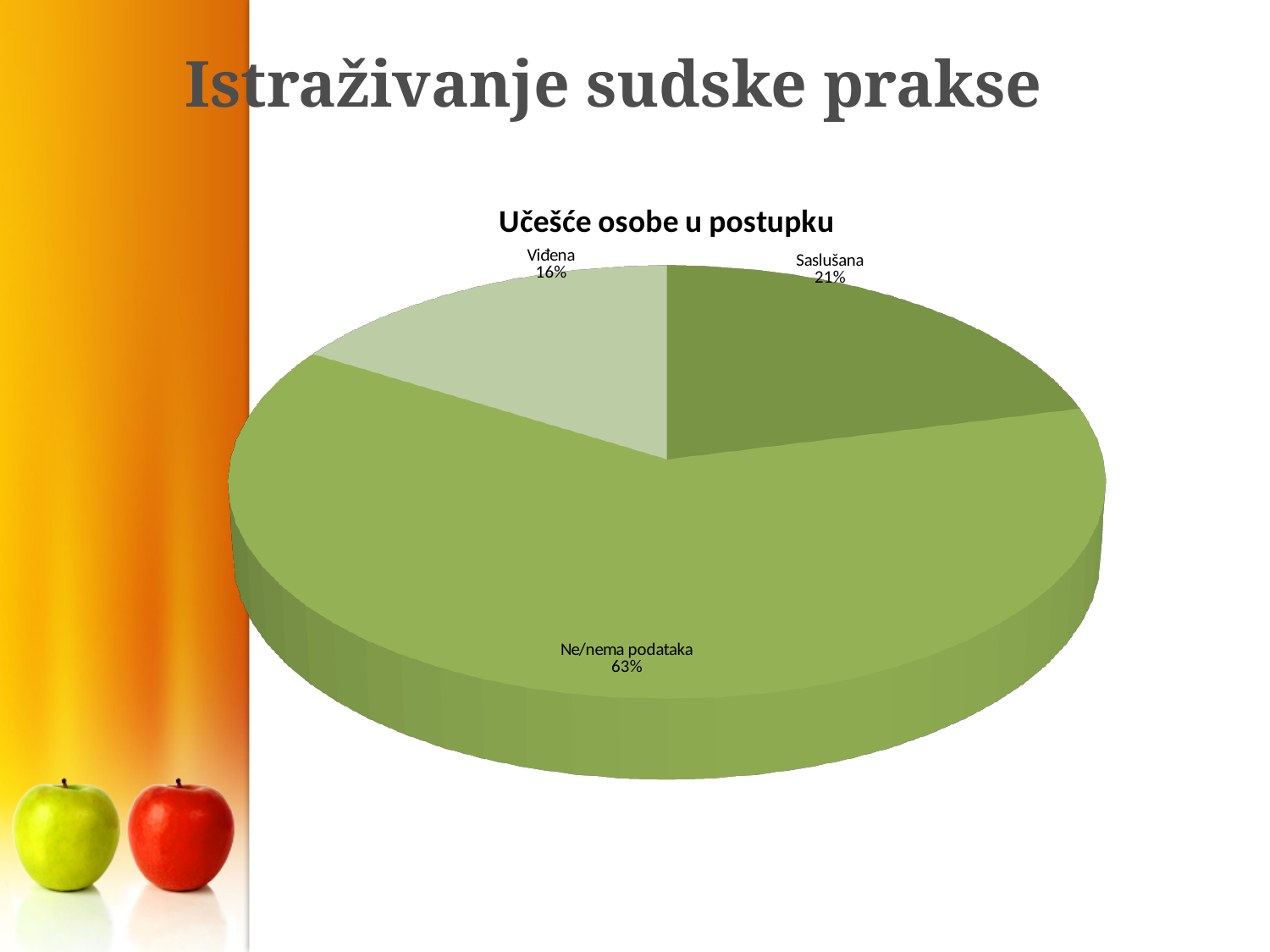
Which category has the smallest slice of the pie? Viđena What is the difference in percentage points between "Ne/nema podataka" and "Saslušana"? 42% What is the difference in percentage points between "Saslušana" and "Viđena"? 5% What share of the pie does "Ne/nema podataka" represent? 63% Which category has the largest slice of the pie? Ne/nema podataka What kind of chart is shown on the slide? pie chart Is the share for "Ne/nema podataka" greater or less than 50%? greater How many slices does the pie chart have? 3 What share of the pie does "Saslušana" represent? 21% Which is larger, the share for "Saslušana" or the share for "Viđena"? Saslušana What is the title of the chart? Učešće osobe u postupku What share of the pie does "Viđena" represent? 16%